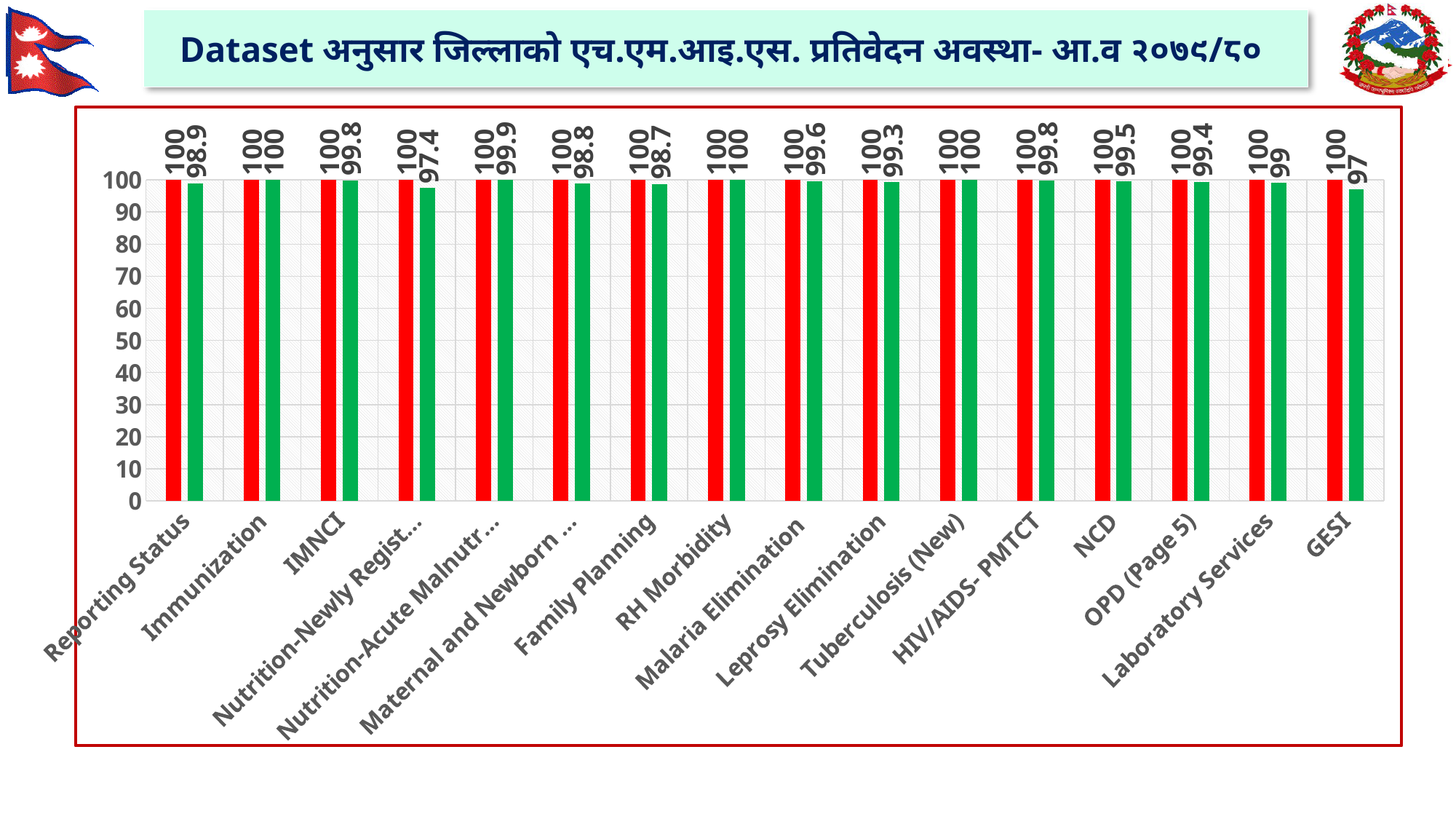
What is the value of the green bar for Reporting Status? 98.9 What is the value of the green bar for GESI? 97 How many categories are shown on the x axis of the chart? 16 What is the value of the red bar for NCD? 100 What two colours are used for the bars in the chart? Red and green Is the green bar value for Nutrition-Newly Regist... greater or less than 90? greater Which category has the lowest green bar value? GESI What kind of chart is shown on the slide? Bar chart Which is larger, the green bar for Immunization or the green bar for GESI? Immunization What is the difference between the red and green bar values for Family Planning? 1.3 What is the difference between the red and green bar values for GESI? 3 What is the value of the green bar for Family Planning? 98.7